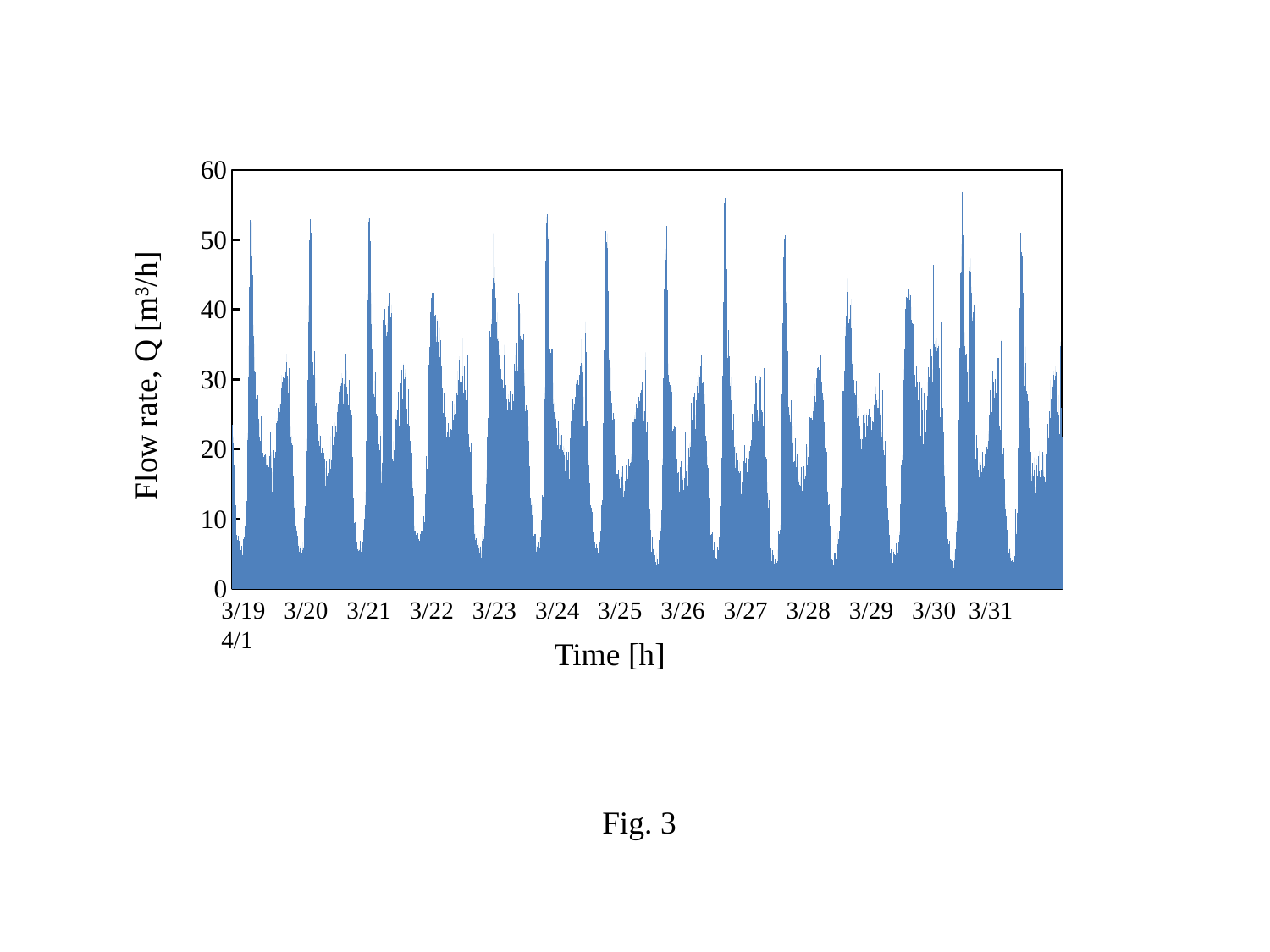
Is the highest peak of the flow rate near 3/27 greater or less than 50? greater What is the label of the y axis? Flow rate, Q [m³/h] Are the lowest daily flow rates greater or less than 10? less What is the label of the x axis? Time [h] What kind of chart is shown on the slide? area chart What is the highest value marked on the y axis? 60 Over the whole period, does the flow rate show a steady rise, a steady fall, or a repeating daily cycle? repeating daily cycle How many date labels are shown on the x axis? 14 Does the flow rate ever exceed 60 on the chart? no What is the first date label on the x axis? 3/19